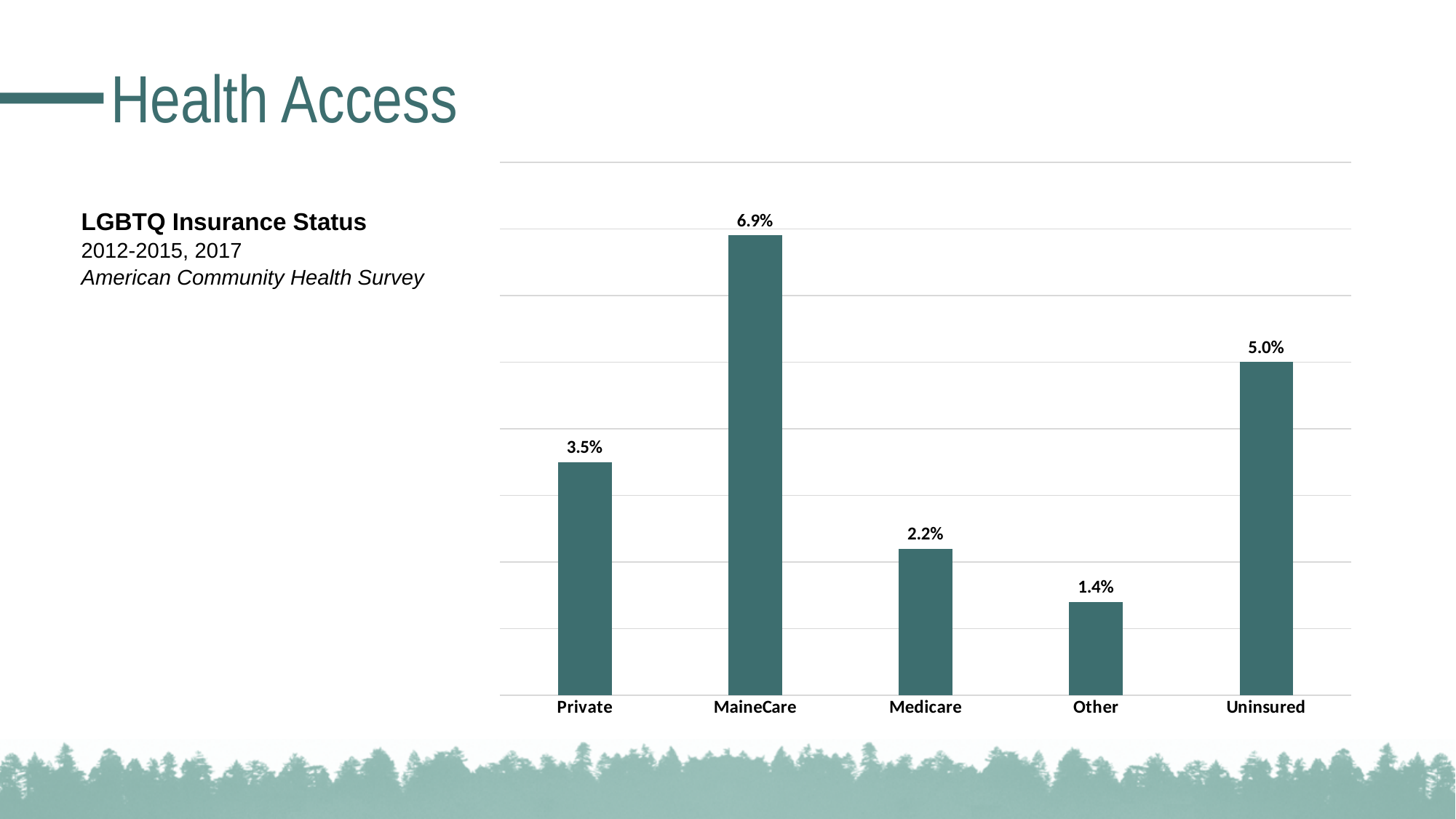
How many categories are shown on the x axis? 5 Which category has the lowest value? Other What is the title of the chart? LGBTQ Insurance Status What is the value for MaineCare? 6.9% What is the value for Other? 1.4% What is the value for Private? 3.5% Which is larger, the value for Private or the value for Medicare? Private What is the difference between the values for Private and Medicare? 1.3% What is the difference between the values for MaineCare and Uninsured? 1.9% What kind of chart is shown on the slide? Bar chart Which category has the highest value? MaineCare What is the value for Uninsured? 5.0%